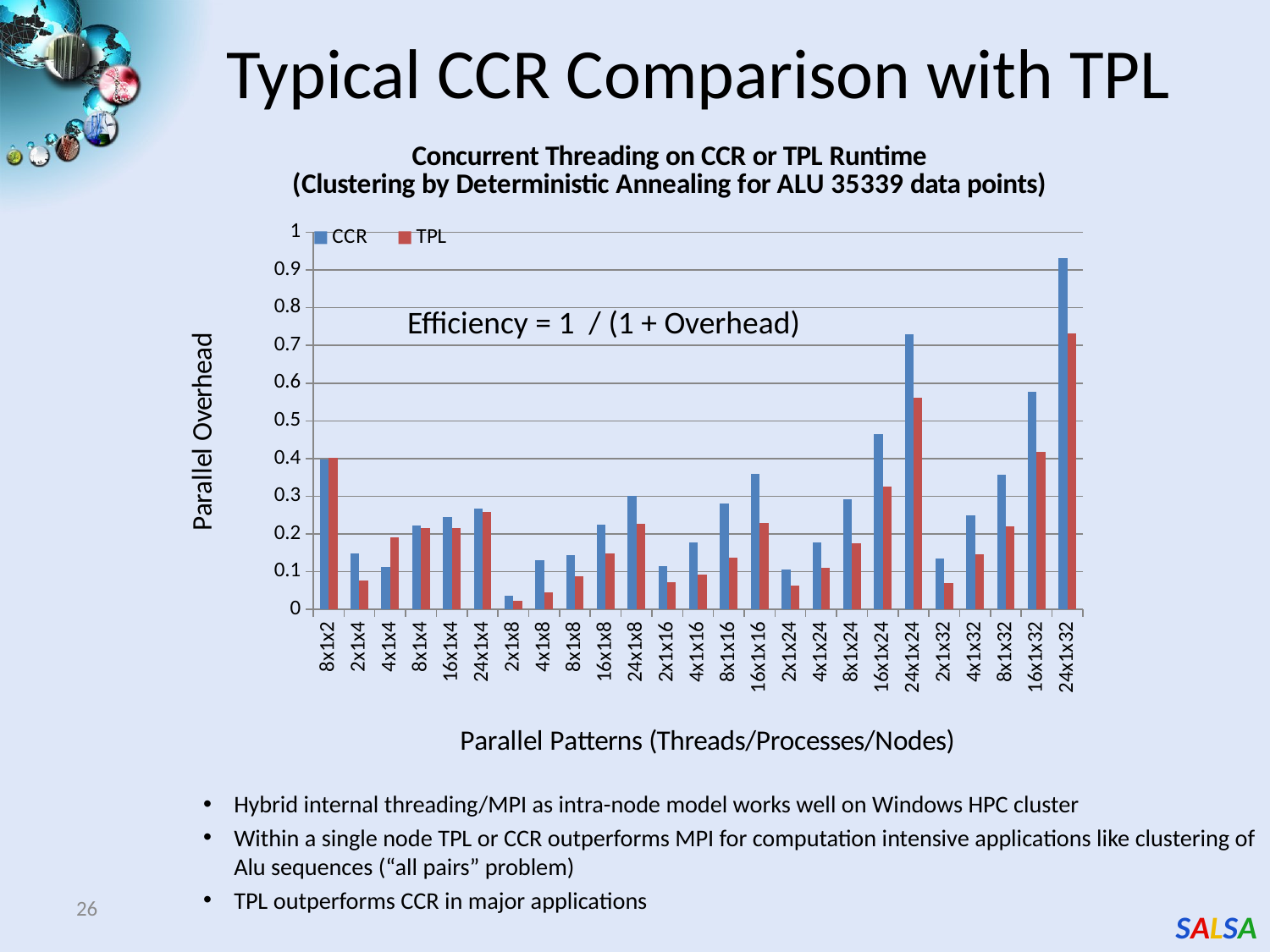
Is the TPL value for 24x1x24 greater or less than 0.5? greater Is the CCR value for 16x1x16 greater or less than 0.4? less What is the label of the chart's y axis? Parallel Overhead How many parallel pattern categories are shown on the x axis? 25 For the 4x1x4 pattern, which series has the larger parallel overhead, CCR or TPL? TPL For which parallel pattern is the CCR parallel overhead highest? 24x1x32 For which parallel pattern is the CCR parallel overhead lowest? 2x1x8 For which parallel pattern is the TPL parallel overhead highest? 24x1x32 What kind of chart is shown on the slide? Bar chart How many series does the chart's legend list? 2 For the 16x1x24 pattern, which series has the larger parallel overhead, CCR or TPL? CCR Is the CCR value for 24x1x32 greater or less than 0.9? greater